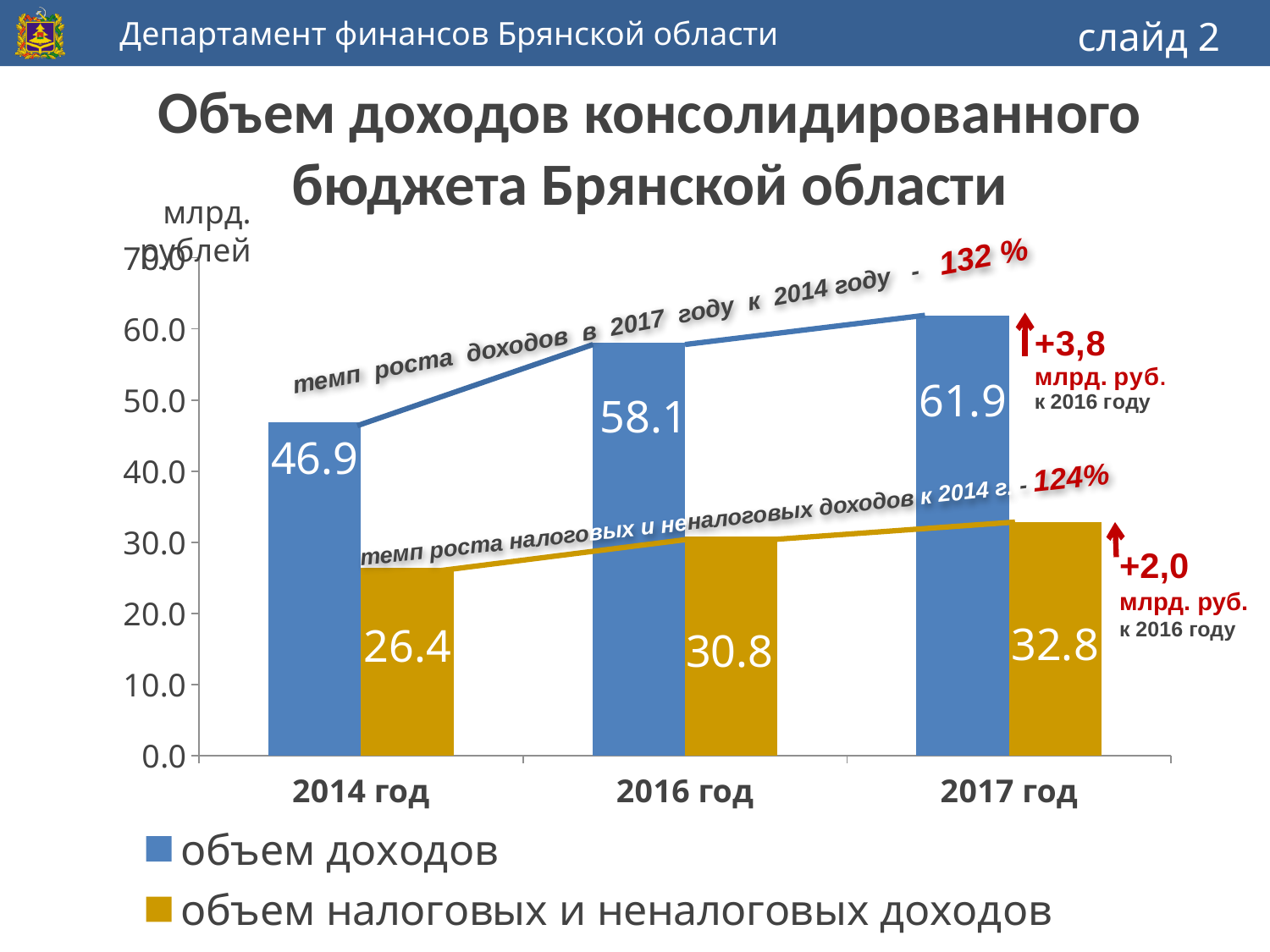
What is the value of объем налоговых и неналоговых доходов for 2017 год? 32.8 Do the values for объем доходов rise or fall from 2014 год to 2017 год? rise How many years are shown on the x axis? 3 Which year has the lowest value for объем налоговых и неналоговых доходов? 2014 год What is the value of объем доходов for 2016 год? 58.1 What kind of chart is shown on the slide? bar chart What is the difference between объем налоговых и неналоговых доходов in 2017 год and in 2014 год? 6.4 How many series does the legend list? 2 Which year has the highest value for объем доходов? 2017 год Which is larger: объем доходов in 2014 год or объем налоговых и неналоговых доходов in 2017 год? объем доходов in 2014 год What is the value of объем доходов for 2014 год? 46.9 What is the difference between объем доходов in 2017 год and in 2016 год? 3.8